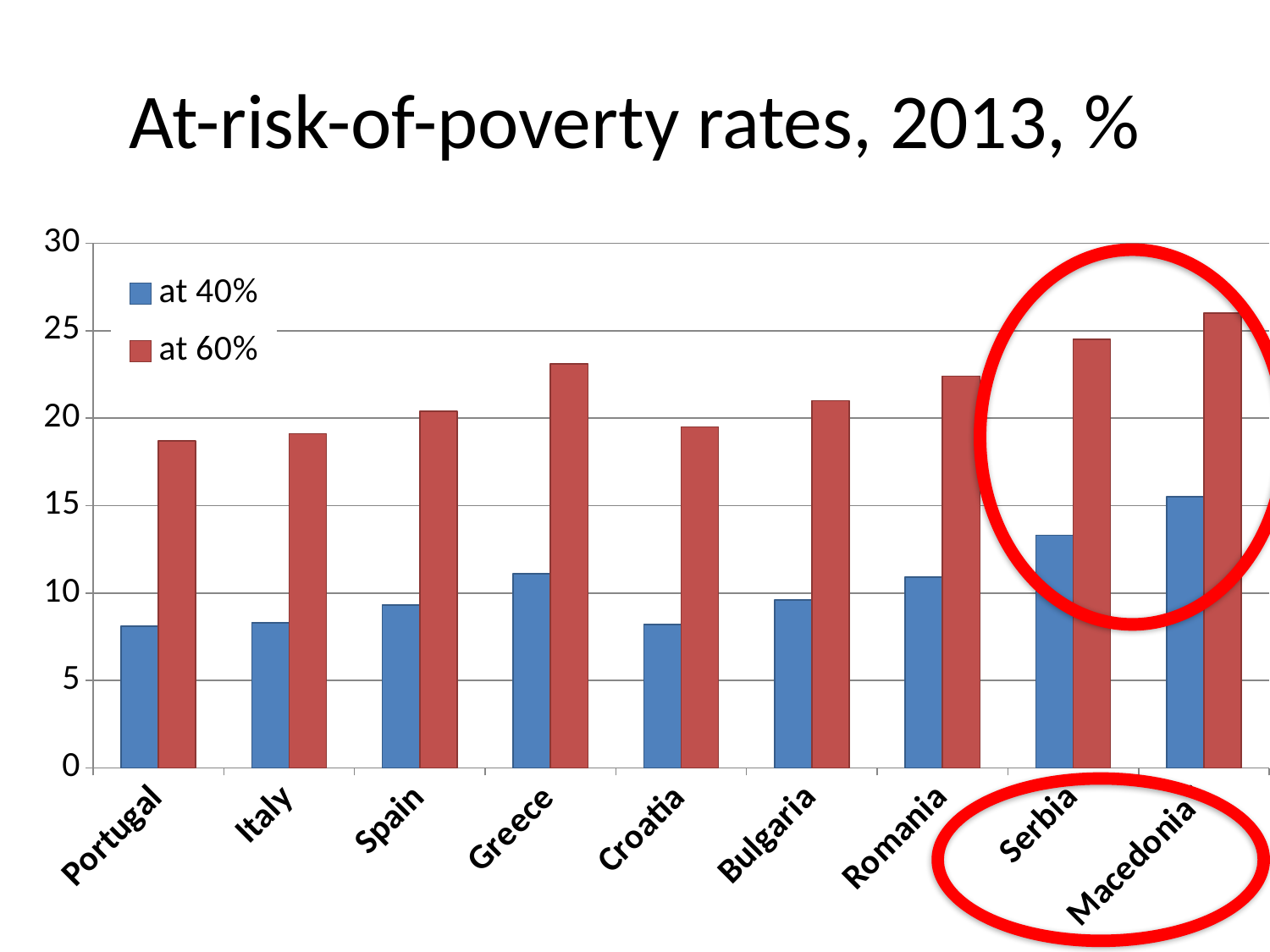
Is the 'at 60%' value for Portugal greater or less than 20? less Is the 'at 60%' value for Macedonia greater or less than 25? greater Is the 'at 40%' value for Croatia greater or less than 10? less Which is larger, the 'at 40%' value for Serbia or the 'at 40%' value for Romania? Serbia What kind of chart is shown on the slide? bar chart How many series does the legend list? 2 Which is larger, the 'at 60%' value for Greece or the 'at 60%' value for Bulgaria? Greece Which country has the highest 'at 40%' at-risk-of-poverty rate? Macedonia What is the title of the chart? At-risk-of-poverty rates, 2013, % Which country has the highest 'at 60%' at-risk-of-poverty rate? Macedonia How many countries are shown on the x axis of the chart? 9